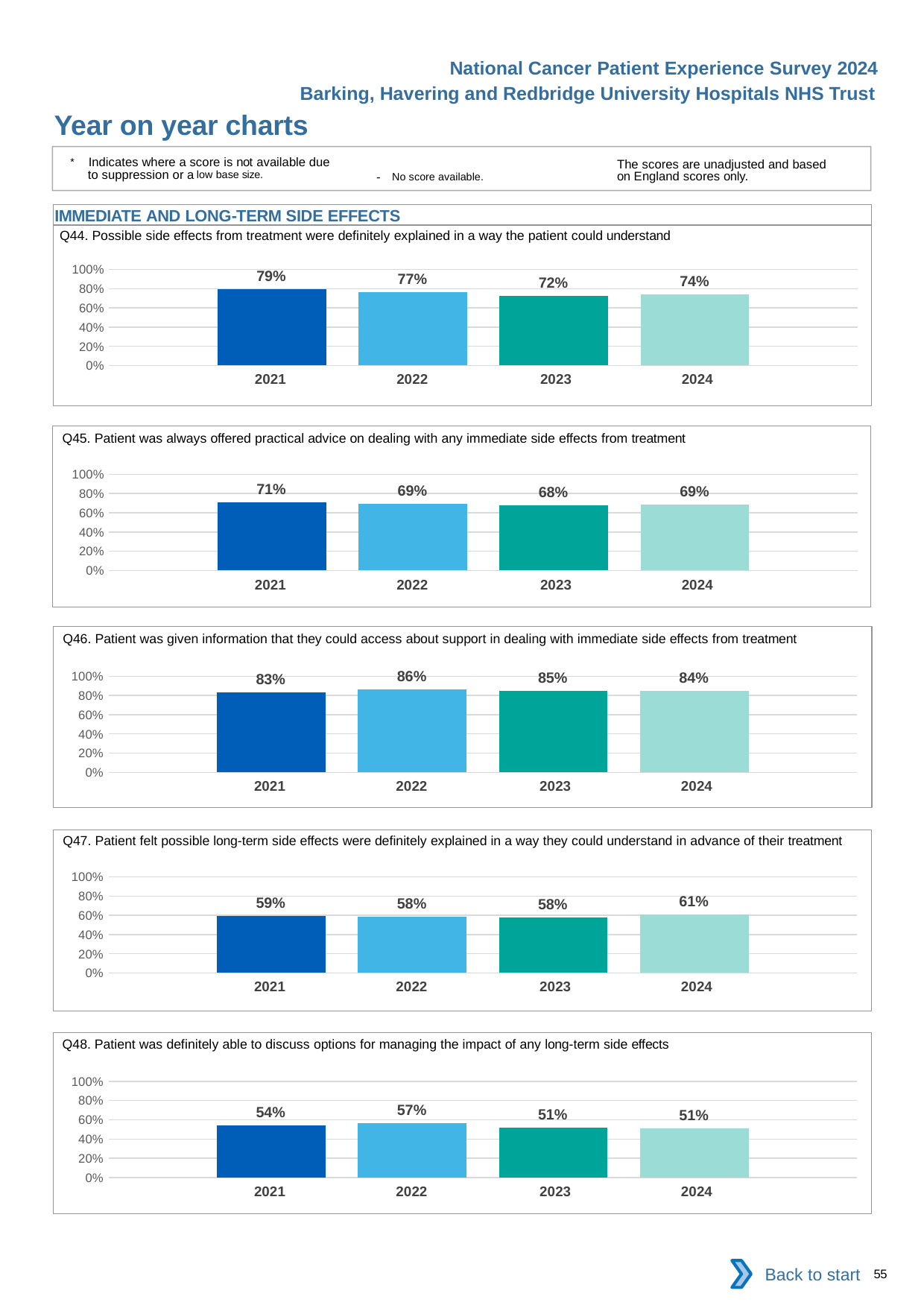
In the Q47 chart, what is the value for 2024? 61% In the Q48 chart, how many years are plotted? 4 In the Q46 chart, which year has the highest value? 2022 In the Q48 chart, what is the difference between the 2022 and 2023 values? 6 percentage points In the Q44 chart, do the values rise or fall from 2021 to 2023? Fall In the Q44 chart, which year has the lowest value? 2023 In the Q45 chart, what is the value for 2024? 69% In the Q47 chart, which is larger, the value for 2021 or the value for 2024? 2024 In the Q45 chart, what is the difference between the 2021 and 2023 values? 3 percentage points What kind of chart is the Q44 chart? Bar chart In the Q46 chart, is the value for 2021 greater or less than 80%? greater In the Q44 chart, what is the value for 2021? 79%